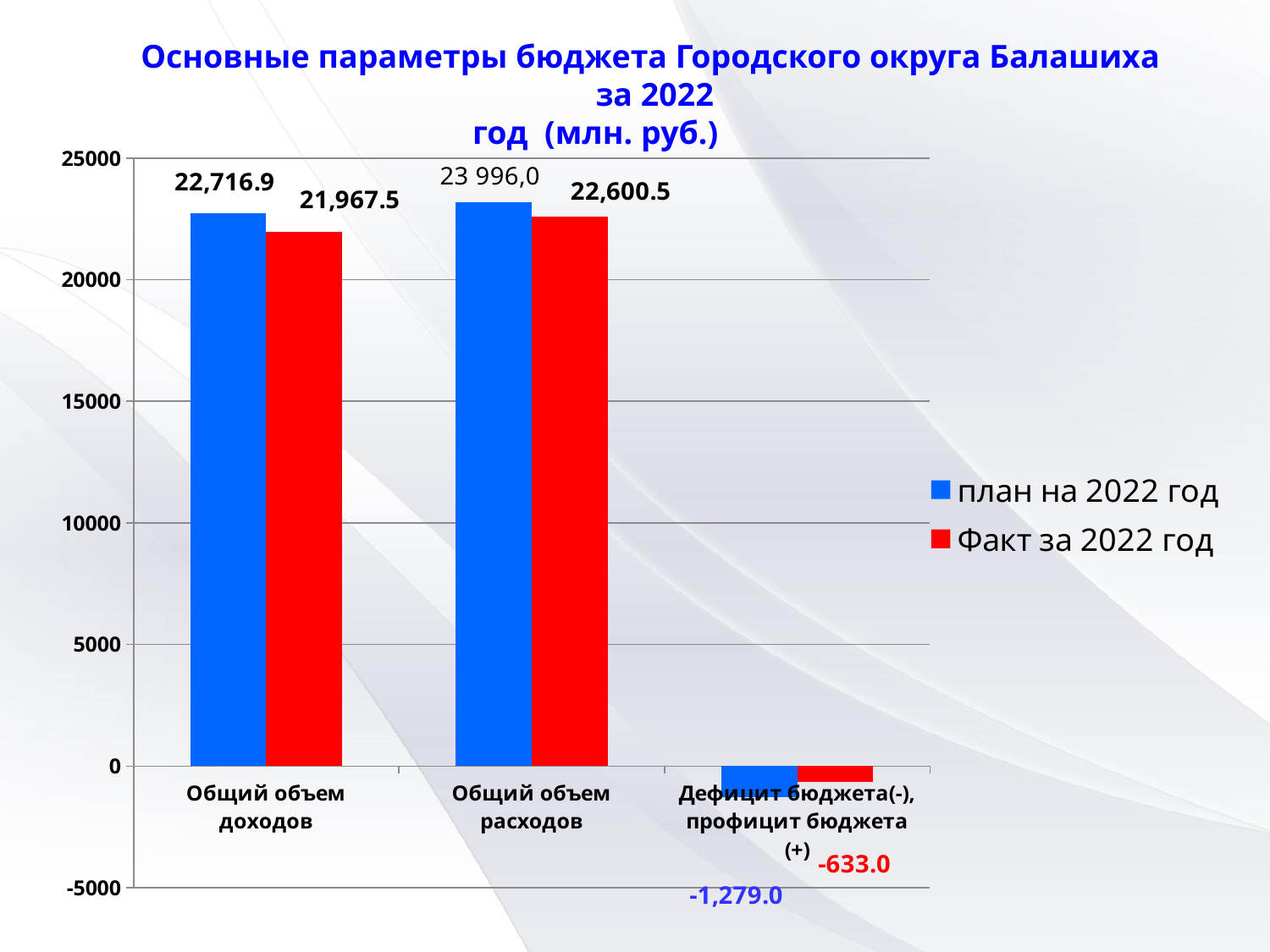
What is the actual value (Факт за 2022 год) for Общий объем расходов? 22,600.5 What is the planned value (план на 2022 год) for Дефицит бюджета(-), профицит бюджета (+)? -1,279.0 Which is larger for Общий объем расходов: the planned value or the actual value? The planned value (23 996,0) Which category has the highest planned value (план на 2022 год)? Общий объем расходов What is the actual value (Факт за 2022 год) for Общий объем доходов? 21,967.5 What is the difference between the planned and actual values for Общий объем доходов? 749.4 What is the planned value (план на 2022 год) for Общий объем доходов? 22,716.9 What is the planned value (план на 2022 год) for Общий объем расходов? 23 996,0 What type of chart is shown on the slide? Bar chart How many categories are shown on the x axis? 3 How many series does the legend list? 2 What is the actual value (Факт за 2022 год) for Дефицит бюджета(-), профицит бюджета (+)? -633.0